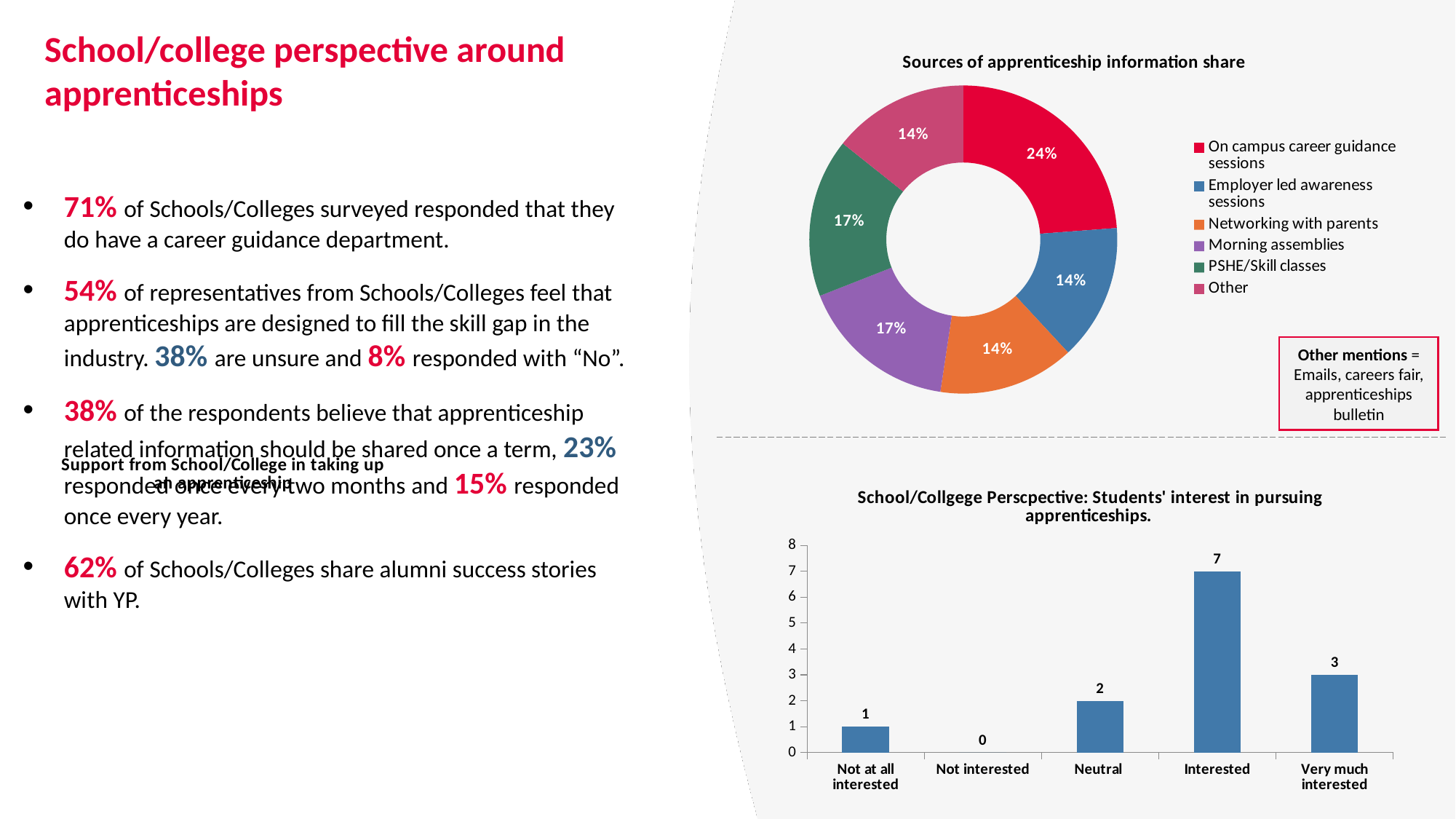
In the 'Sources of apprenticeship information share' chart, how many entries does the legend list? 6 In the 'Students' interest in pursuing apprenticeships' chart, what is the difference between the value for Interested and the value for Not at all interested? 6 In the 'Students' interest in pursuing apprenticeships' chart, what is the value for Interested? 7 In the 'Sources of apprenticeship information share' chart, what share is shown for On campus career guidance sessions? 24% In the 'Students' interest in pursuing apprenticeships' chart, which is larger: the value for Neutral or the value for Very much interested? Very much interested In the 'Sources of apprenticeship information share' chart, what is the difference between the share for On campus career guidance sessions and the share for Networking with parents? 10% In the 'Sources of apprenticeship information share' chart, what share is shown for Morning assemblies? 17% In the 'Students' interest in pursuing apprenticeships' chart, how many categories are shown on the x axis? 5 In the 'Students' interest in pursuing apprenticeships' chart, what is the value for Very much interested? 3 What kind of chart is 'Sources of apprenticeship information share'? Doughnut chart In the 'Students' interest in pursuing apprenticeships' chart, which category has the lowest value? Not interested In the 'Sources of apprenticeship information share' chart, which source has the largest share? On campus career guidance sessions